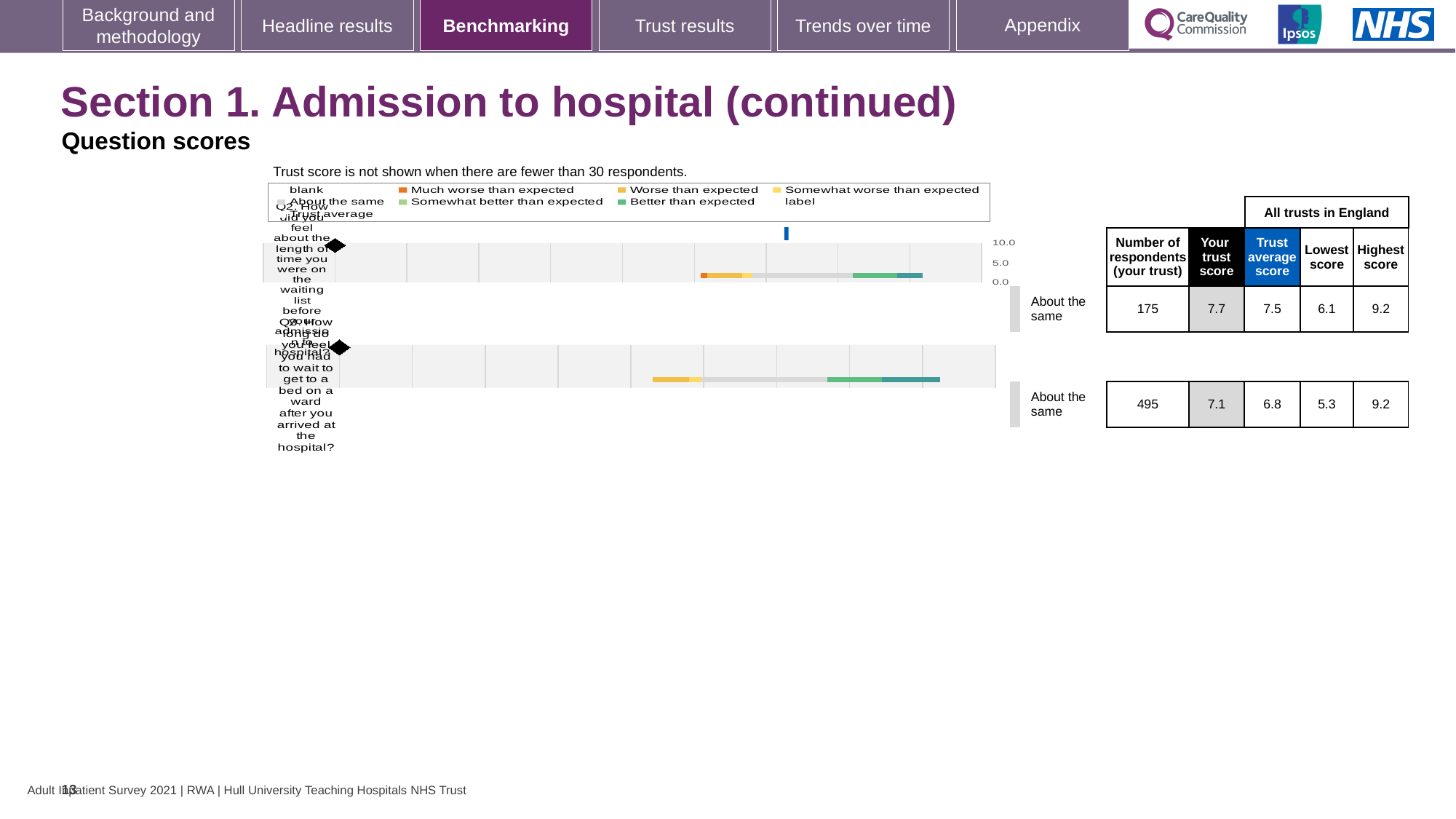
What is the trust score for Q3 (wait to get to a bed on a ward after arriving at the hospital)? 7.1 How many respondents from the trust answered Q3? 495 What type of chart is used to show the question scores? Bar chart What is the difference between the trust score and the trust average score for Q2? 0.2 What is the difference between the highest and lowest scores across all trusts in England for Q3? 3.9 What is the highest score across all trusts in England for Q2? 9.2 How is the trust's Q3 score categorised relative to other trusts? About the same What is the maximum value shown on the score axis of the benchmarking charts? 10.0 What is the lowest score across all trusts in England for Q3? 5.3 What is the trust score for Q2 (length of time on the waiting list before admission)? 7.7 What is the trust average score across all trusts in England for Q2? 7.5 Which question has the higher trust score, Q2 or Q3? Q2